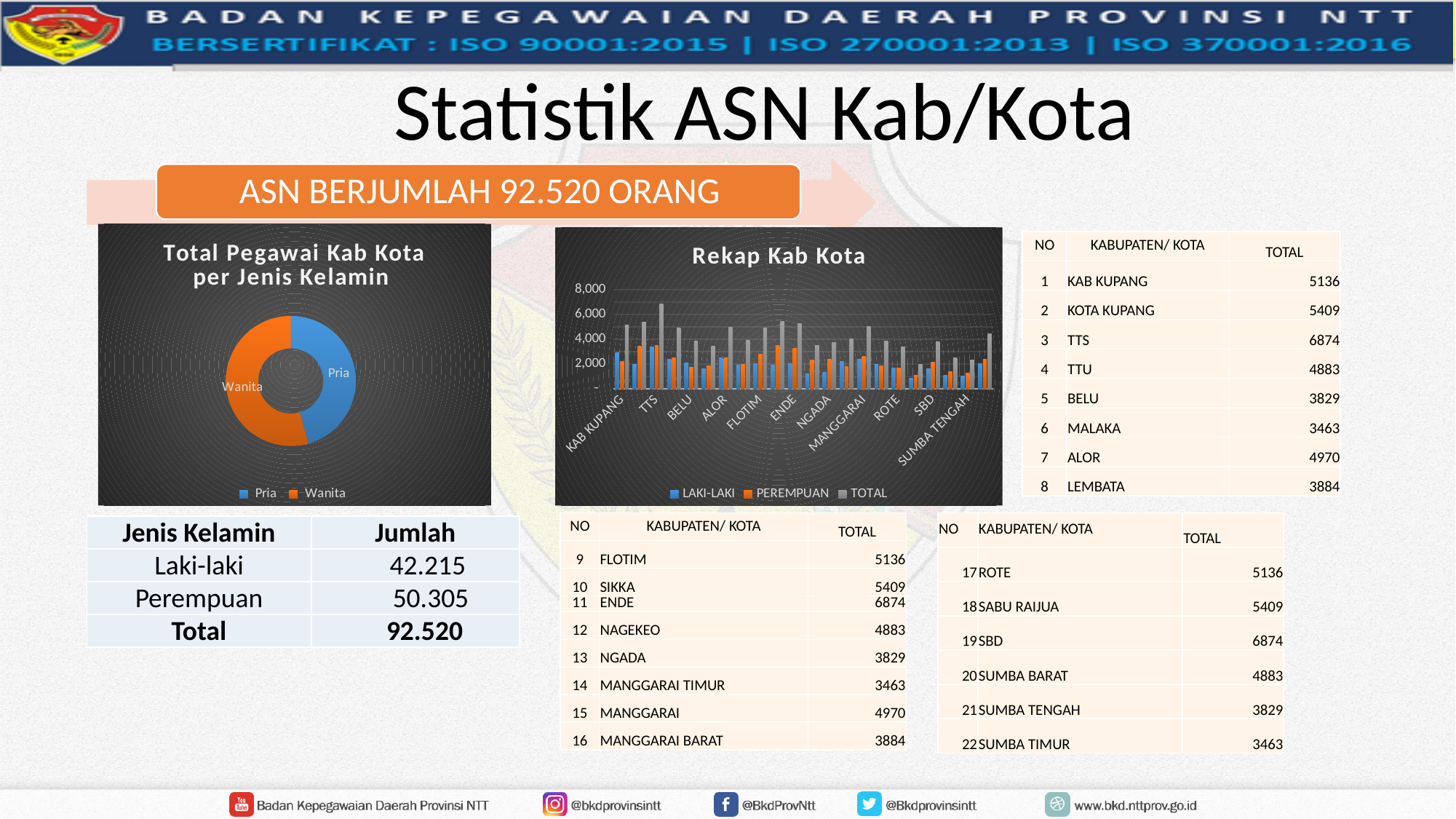
In the 'Rekap Kab Kota' chart, is the TOTAL value for KAB KUPANG greater or less than 4,000? greater In the 'Rekap Kab Kota' chart, which labelled category has the highest TOTAL bar? TTS In the 'Rekap Kab Kota' chart, is the TOTAL value for TTS greater or less than 6,000? greater In the 'Total Pegawai Kab Kota per Jenis Kelamin' chart, which slice is larger, Pria or Wanita? Wanita How many series does the legend of the 'Rekap Kab Kota' chart list? 3 How many entries does the legend of the 'Total Pegawai Kab Kota per Jenis Kelamin' chart list? 2 How many categories are shown in the 'Total Pegawai Kab Kota per Jenis Kelamin' chart? 2 In the 'Rekap Kab Kota' chart, is the LAKI-LAKI value for KAB KUPANG greater or less than 4,000? less In the 'Rekap Kab Kota' chart, which has the larger TOTAL bar, TTS or KAB KUPANG? TTS What kind of chart is the 'Total Pegawai Kab Kota per Jenis Kelamin' chart? Doughnut chart What are the legend entries of the 'Rekap Kab Kota' chart? LAKI-LAKI, PEREMPUAN, TOTAL What kind of chart is the 'Rekap Kab Kota' chart? Bar chart